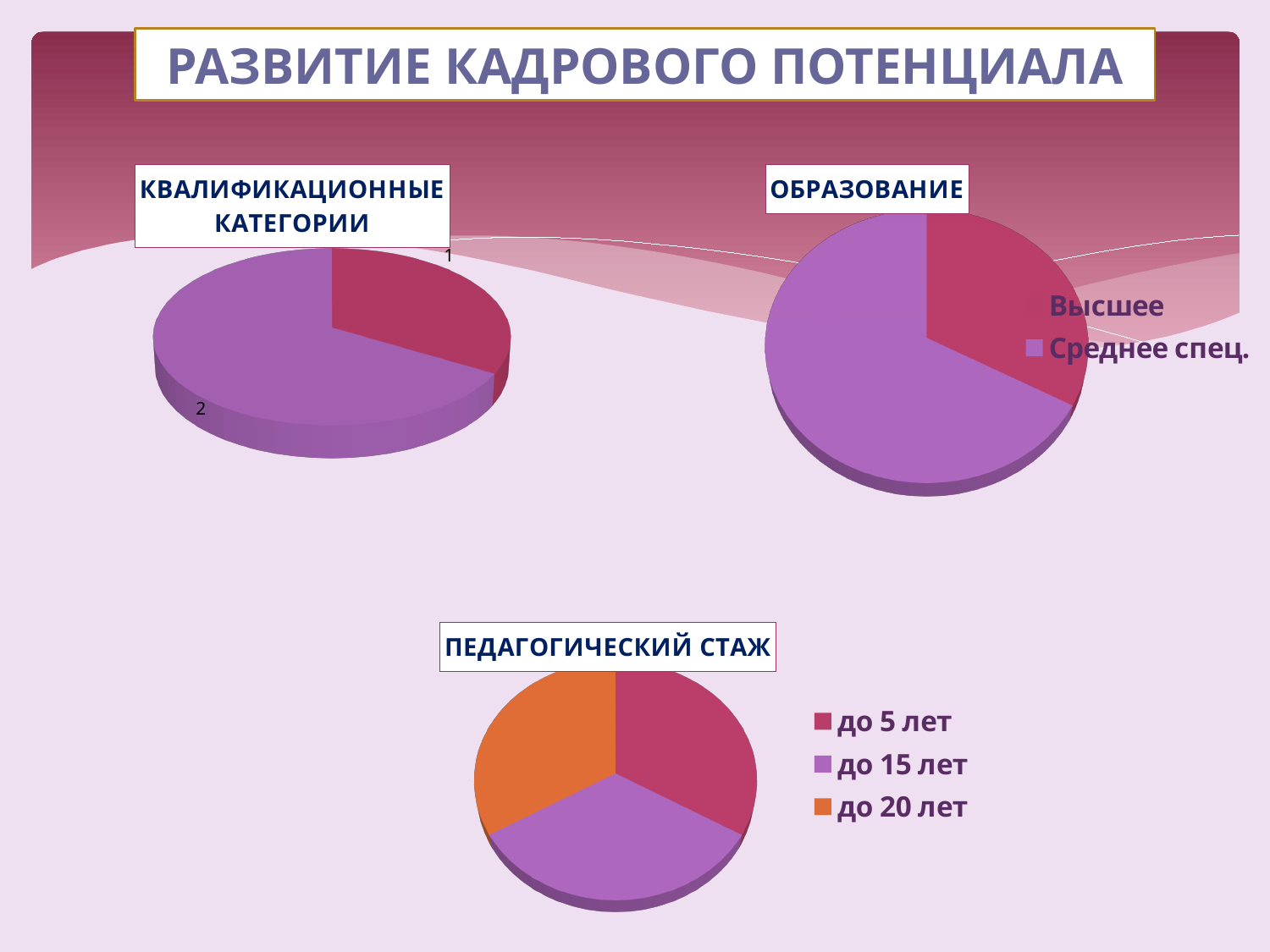
In the "ОБРАЗОВАНИЕ" pie chart, which is larger, Высшее or Среднее спец.? Среднее спец. What kind of chart is the "ПЕДАГОГИЧЕСКИЙ СТАЖ" chart? Pie chart How many pie charts are shown on the slide? 3 In the "КВАЛИФИКАЦИОННЫЕ КАТЕГОРИИ" pie chart, which slice is the largest? 2 How many categories does the "ПЕДАГОГИЧЕСКИЙ СТАЖ" pie chart show? 3 In the "ПЕДАГОГИЧЕСКИЙ СТАЖ" chart, what colour represents "до 20 лет"? Orange How many slices does the "КВАЛИФИКАЦИОННЫЕ КАТЕГОРИИ" pie chart have? 2 What kind of chart is the "КВАЛИФИКАЦИОННЫЕ КАТЕГОРИИ" chart? Pie chart In the "ОБРАЗОВАНИЕ" pie chart, which category has the smallest share? Высшее How many entries does the legend of the "ОБРАЗОВАНИЕ" chart list? 2 In the "КВАЛИФИКАЦИОННЫЕ КАТЕГОРИИ" pie chart, which slice is larger, 1 or 2? 2 In the "ОБРАЗОВАНИЕ" pie chart, which category has the largest share? Среднее спец.